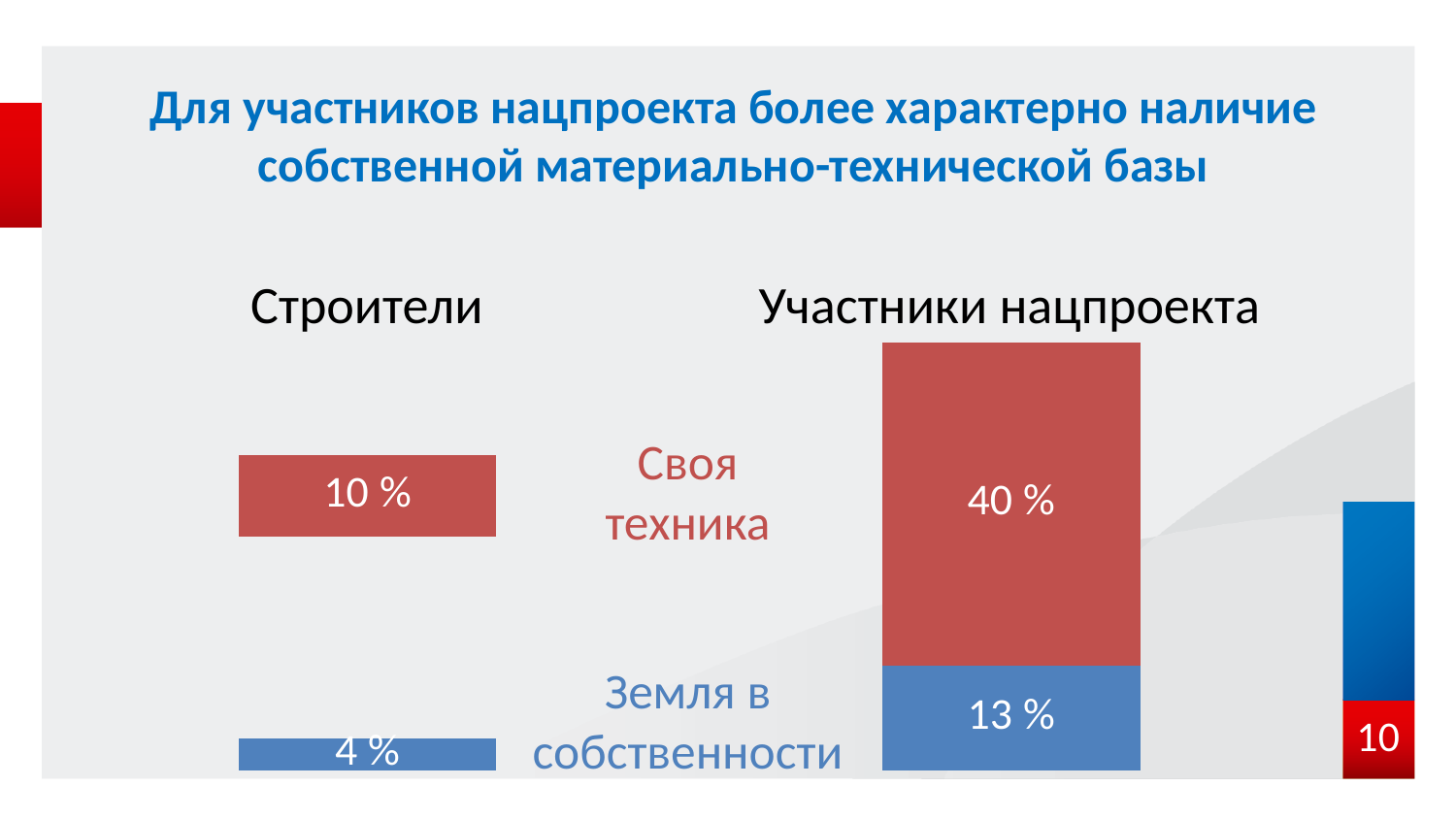
What is the value for "Своя техника" for "Участники нацпроекта"? 40 % What is the difference between the "Земля в собственности" values for "Участники нацпроекта" and "Строители"? 9 % What is the total of the two values shown for "Участники нацпроекта"? 53 % What is the value for "Земля в собственности" for "Участники нацпроекта"? 13 % What is the value for "Своя техника" for "Строители"? 10 % What colour represents "Своя техника" in the chart? Red How many series does the chart show? 2 Which group has the higher value for "Своя техника": "Строители" or "Участники нацпроекта"? Участники нацпроекта What is the difference between the "Своя техника" values for "Участники нацпроекта" and "Строители"? 30 % What is the total of the two values shown for "Строители"? 14 % What is the value for "Земля в собственности" for "Строители"? 4 % How many groups (categories) are compared in the chart? 2